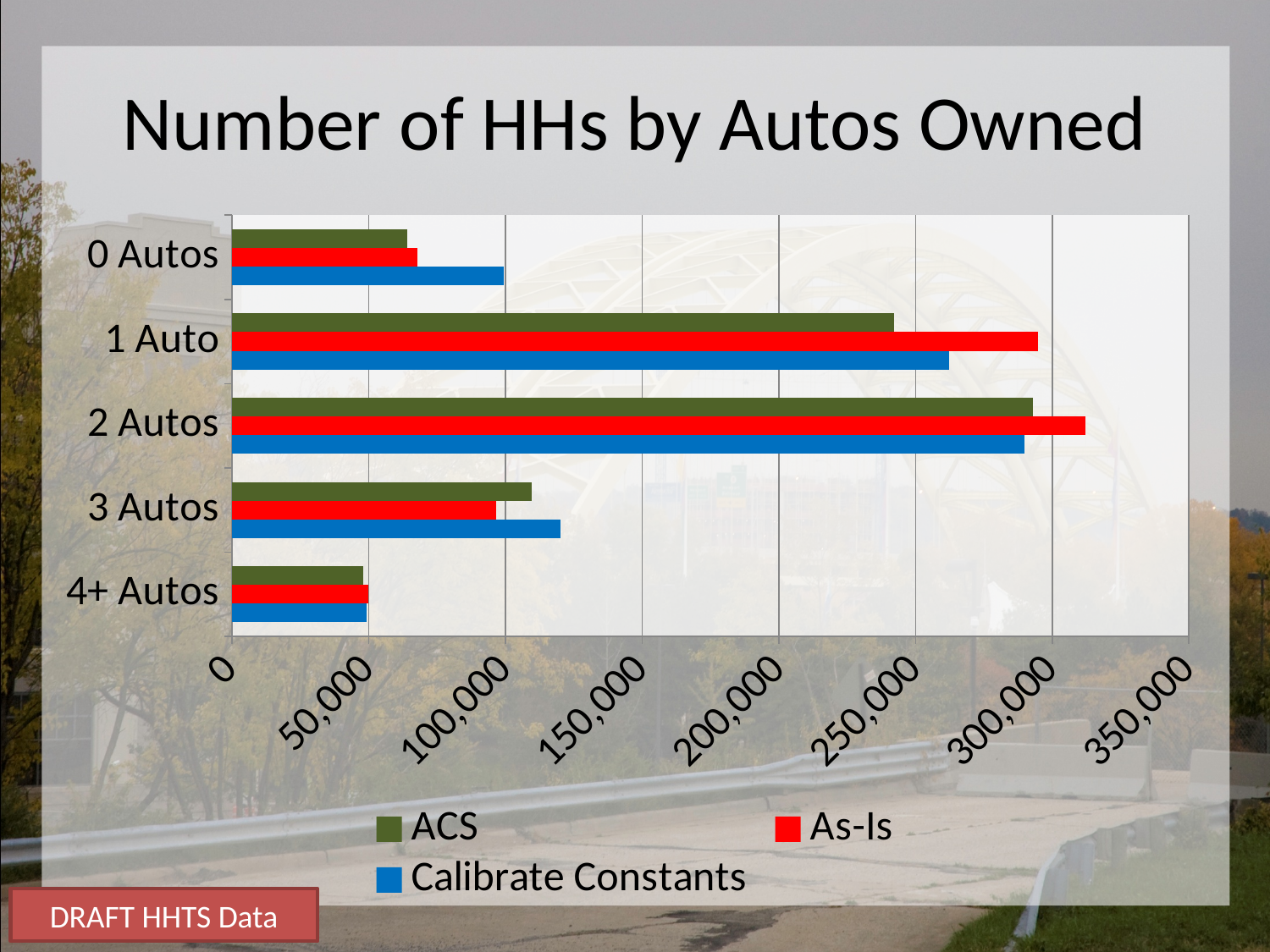
Which category has the highest Calibrate Constants value? 2 Autos Is the As-Is value for 3 Autos greater or less than 100,000? less Which category has the highest As-Is value? 2 Autos What colour represents the As-Is series in the legend? red For 1 Auto, which is larger: the ACS value or the As-Is value? As-Is Is the Calibrate Constants value for 0 Autos greater or less than 50,000? greater Is the As-Is value for 2 Autos greater or less than 300,000? greater For 0 Autos, which is larger: the ACS value or the Calibrate Constants value? Calibrate Constants What kind of chart is shown on the slide? bar chart How many series does the legend list? 3 Which category has the lowest ACS value? 4+ Autos How many auto-ownership categories are shown on the chart? 5